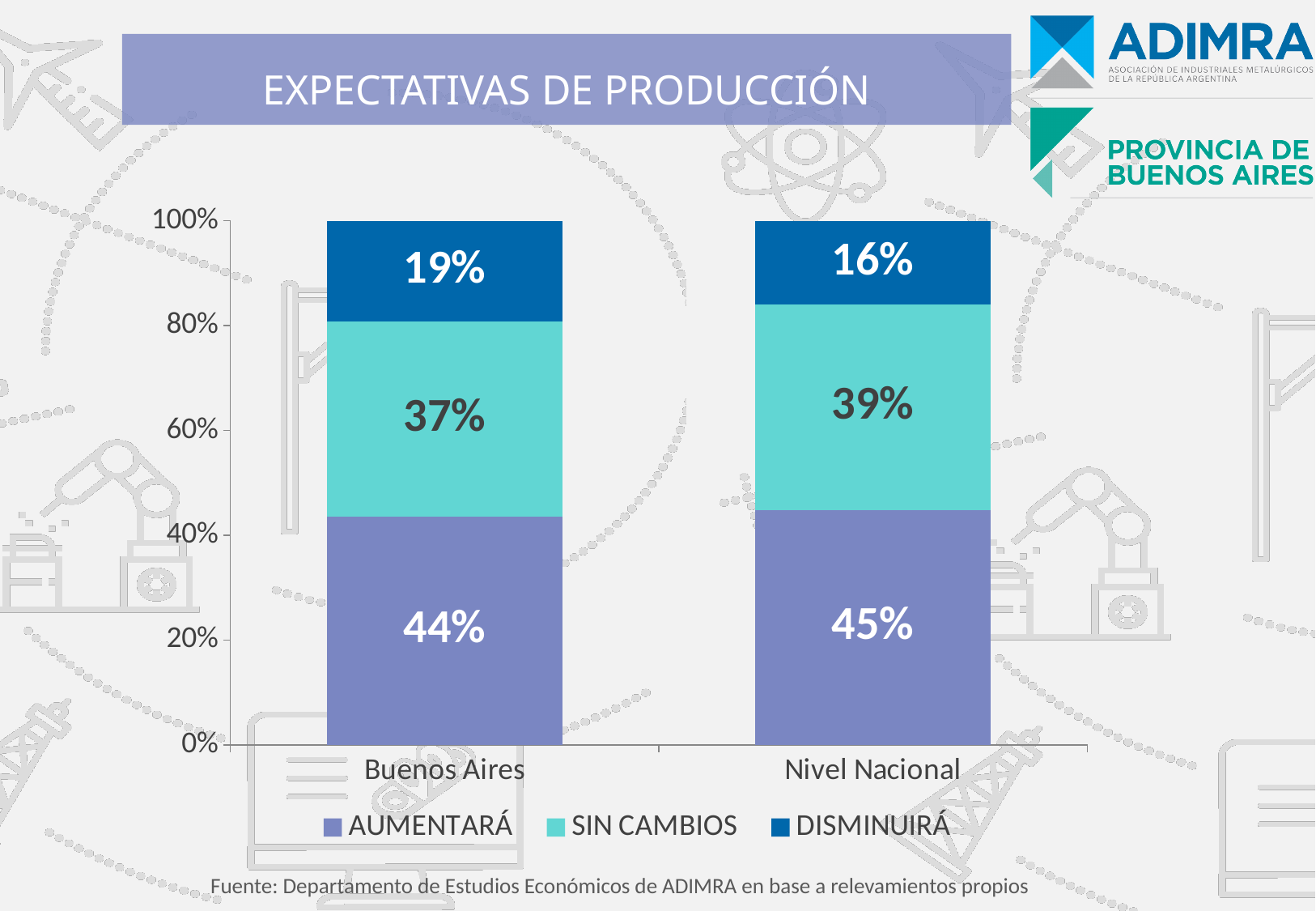
How many series does the legend list? 3 What type of chart is shown on the slide? Stacked bar chart What is the difference between the DISMINUIRÁ values for Buenos Aires and Nivel Nacional? 3% What is the AUMENTARÁ value for Nivel Nacional? 45% Which category has the higher DISMINUIRÁ value, Buenos Aires or Nivel Nacional? Buenos Aires What is the SIN CAMBIOS value for Nivel Nacional? 39% What percentage of respondents in Buenos Aires expect production to increase (AUMENTARÁ)? 44% Which segment is the smallest in the Nivel Nacional bar? DISMINUIRÁ How many categories are shown on the x axis? 2 Which segment is the largest in the Buenos Aires bar? AUMENTARÁ What is the difference between the SIN CAMBIOS values for Nivel Nacional and Buenos Aires? 2% What is the DISMINUIRÁ value for Buenos Aires? 19%